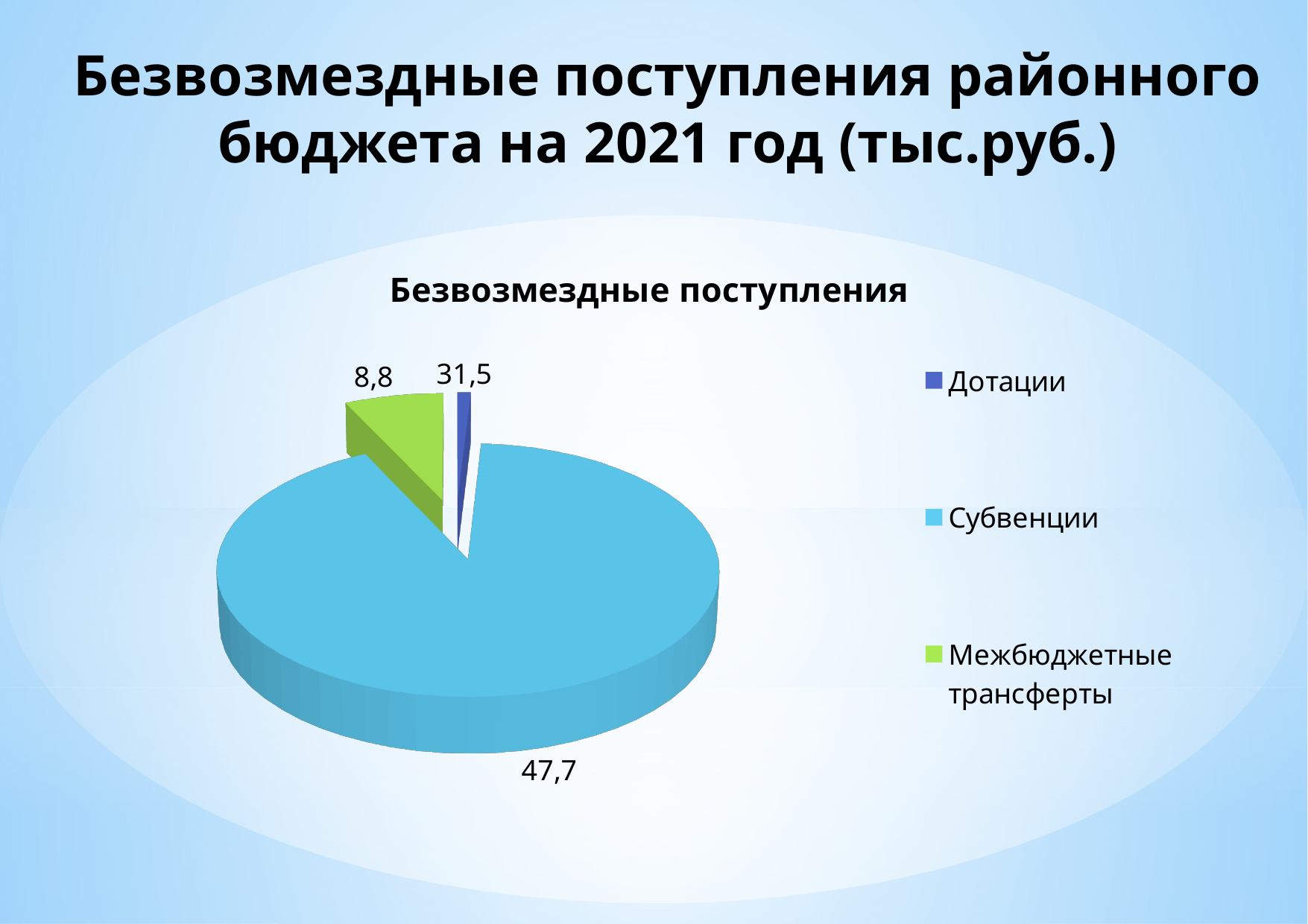
What kind of chart is shown on the slide? pie chart What is the difference between the values for Субвенции and Дотации? 16,2 Which is larger, the value for Субвенции or the value for Межбюджетные трансферты? Субвенции What is the value shown for Межбюджетные трансферты? 8,8 Which colour represents Межбюджетные трансферты in the legend? green How many slices does the pie chart have? 3 How many entries does the legend list? 3 What is the value shown for Дотации? 31,5 What is the title of the chart? Безвозмездные поступления What is the difference between the values for Субвенции and Межбюджетные трансферты? 38,9 Which category has the largest slice of the pie? Субвенции What is the value shown for Субвенции? 47,7